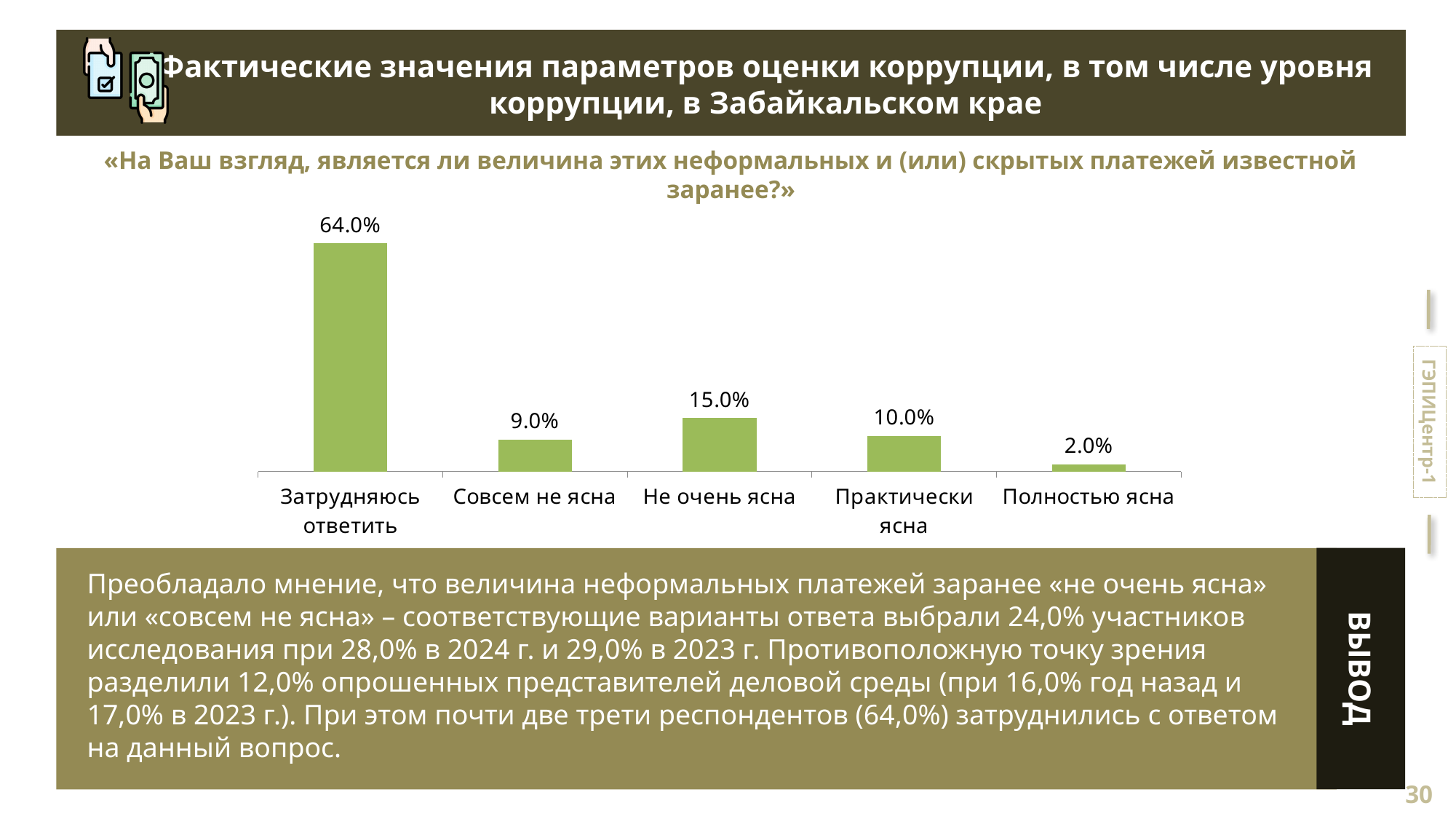
What kind of chart is shown on the slide? Bar chart What is the combined value of «Не очень ясна» and «Совсем не ясна»? 24.0% Which category has the highest value? Затрудняюсь ответить Which is larger, the value for «Практически ясна» or the value for «Совсем не ясна»? Практически ясна What is the value for «Затрудняюсь ответить»? 64.0% What is the value for «Практически ясна»? 10.0% What is the value for «Полностью ясна»? 2.0% What is the value for «Совсем не ясна»? 9.0% What is the difference between the values for «Не очень ясна» and «Совсем не ясна»? 6.0% Which category has the lowest value? Полностью ясна How many categories are shown in the chart? 5 What is the value for «Не очень ясна»? 15.0%